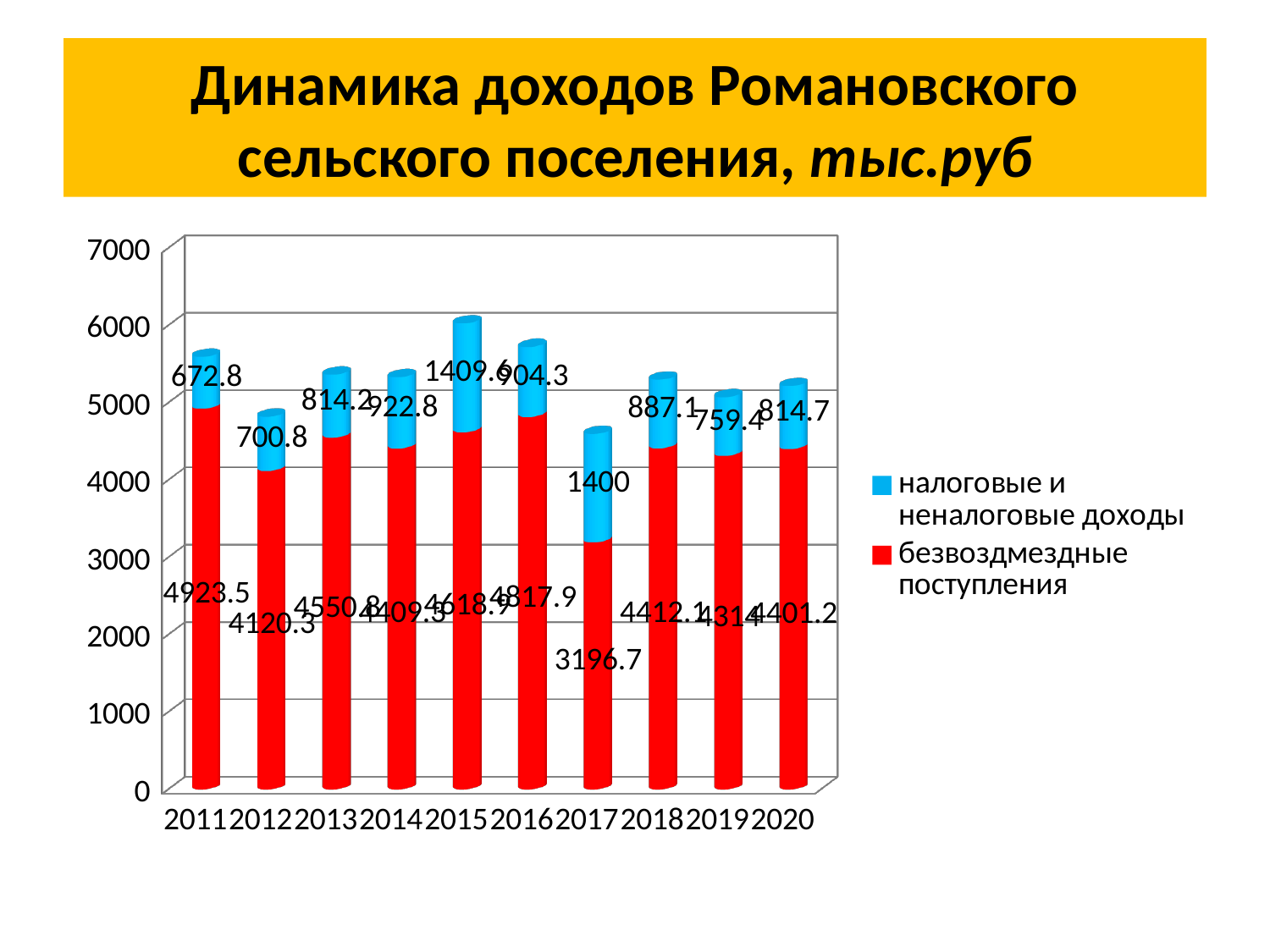
In which year were безвоздмездные поступления the lowest? 2017 What is the value of безвоздмездные поступления in 2017? 3196.7 In which year were безвоздмездные поступления the highest? 2011 By how much did налоговые и неналоговые доходы in 2012 exceed those in 2011? 28 What is the value of безвоздмездные поступления in 2011? 4923.5 How many series does the legend list? 2 Is the total height of the 2012 bar greater or less than 5000? less What kind of chart is shown on the slide? Stacked bar chart What is the total income (both series combined) for 2017? 4596.7 Which year had higher налоговые и неналоговые доходы, 2013 or 2014? 2014 How many years are shown along the x axis? 10 What is the value of налоговые и неналоговые доходы in 2017? 1400